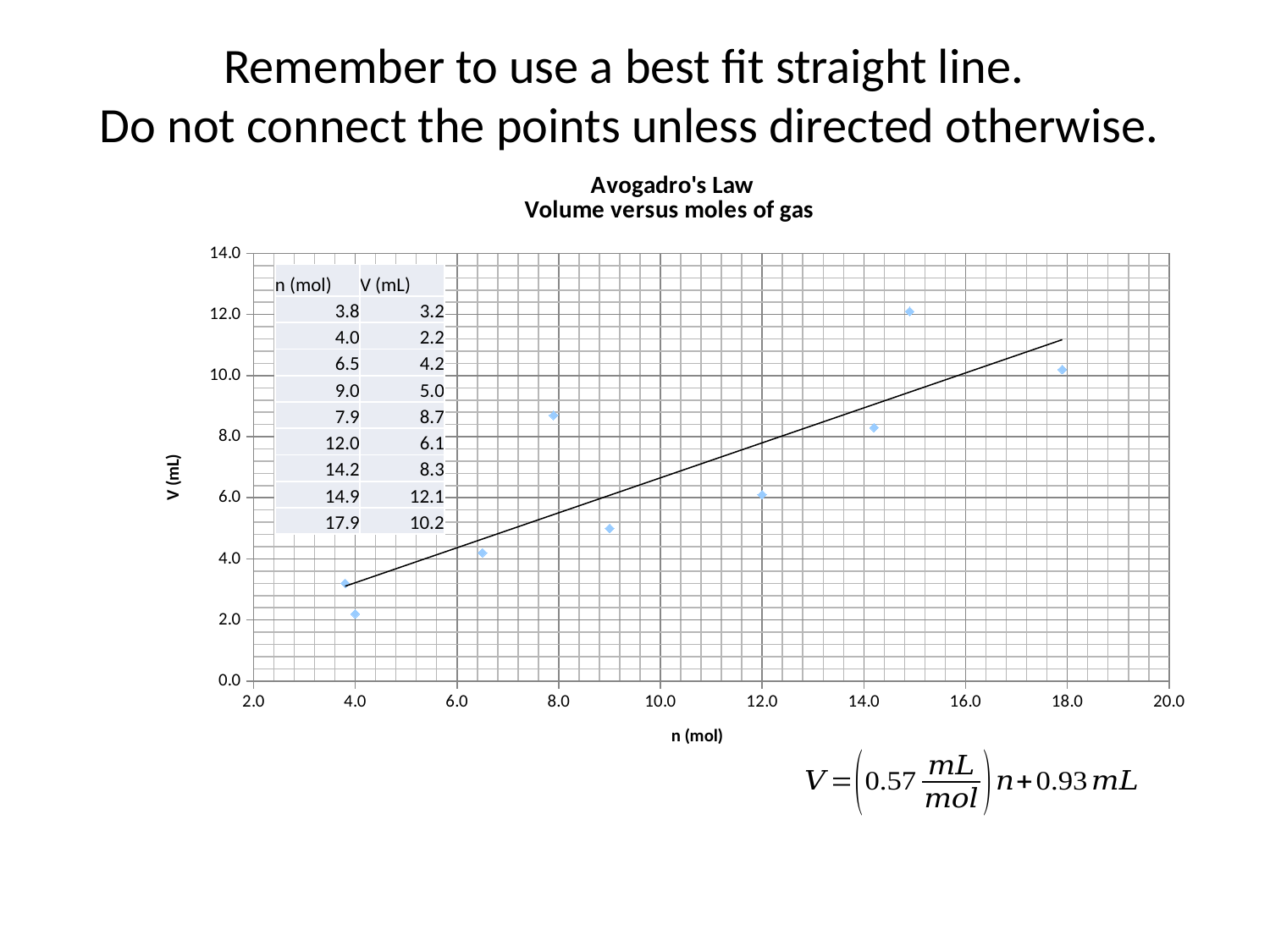
Does the best fit line rise or fall as n (mol) increases? rises What is the volume V (mL) when n is 17.9 mol? 10.2 At which value of n (mol) is the volume highest? 14.9 What is the difference in V (mL) between the points at n = 14.9 mol and n = 17.9 mol? 1.9 At which value of n (mol) is the volume lowest? 4.0 What kind of chart is shown on the slide? scatter chart What is the volume V (mL) when n is 14.9 mol? 12.1 How many data points are plotted on the chart? 9 Which has the larger volume: the point at n = 9.0 mol or the point at n = 7.9 mol? n = 7.9 mol What is the volume V (mL) when n is 7.9 mol? 8.7 What is the title of the chart? Avogadro's Law Volume versus moles of gas Is the volume at n = 12.0 mol greater or less than 8.0 mL? less